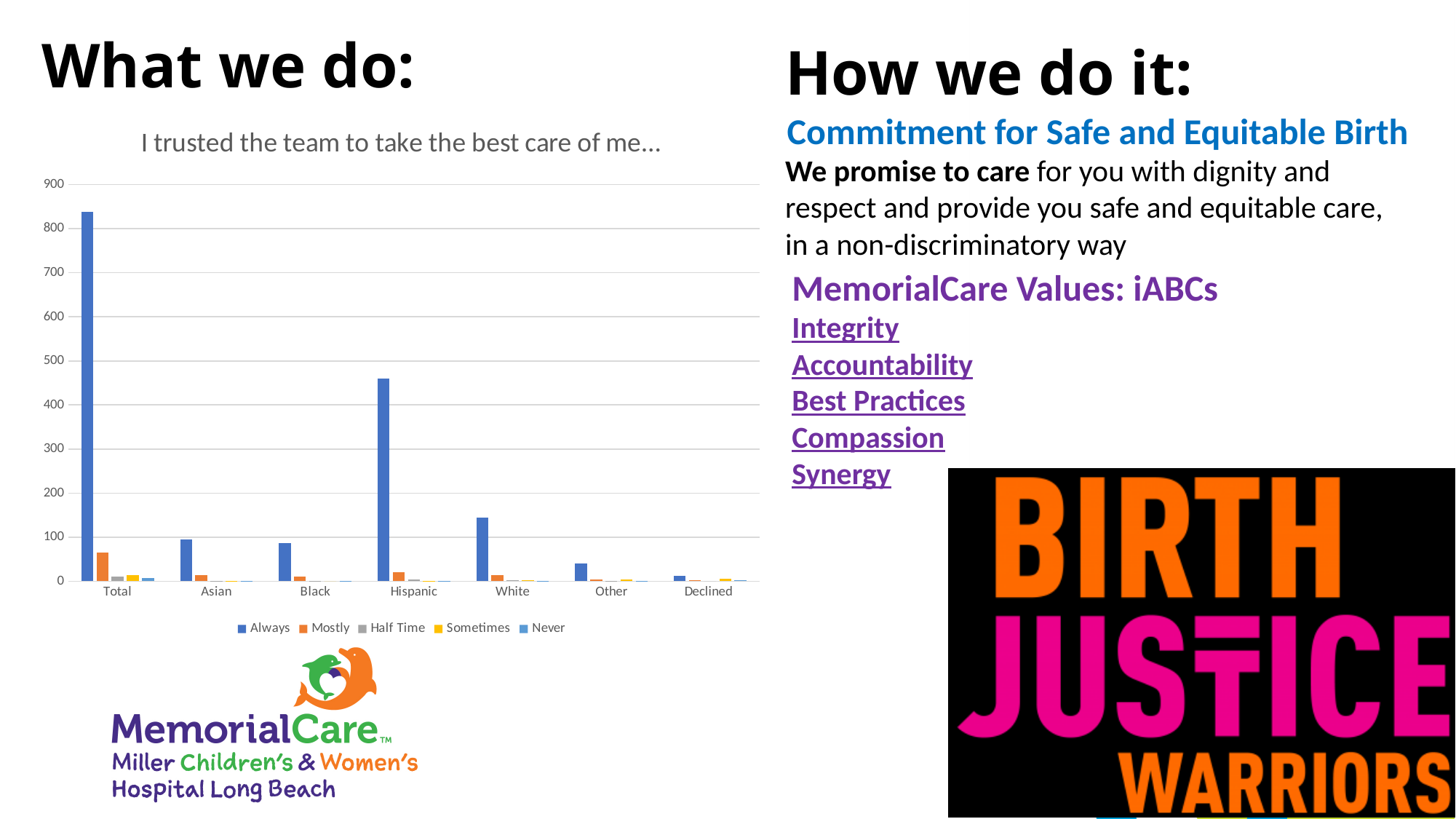
What is the title of the chart? I trusted the team to take the best care of me... How many series does the chart's legend list? 5 Which category has the highest 'Always' value? Total Is the 'Always' value for White greater or less than 100? greater Which series is listed first in the chart's legend? Always Which category has the lowest 'Always' value? Declined Which is larger, the 'Always' value for Hispanic or for White? Hispanic What kind of chart is shown on the slide? bar chart Is the 'Always' value for Total greater or less than 800? greater Is the 'Always' value for Hispanic greater or less than 400? greater How many categories are shown on the x axis of the chart? 7